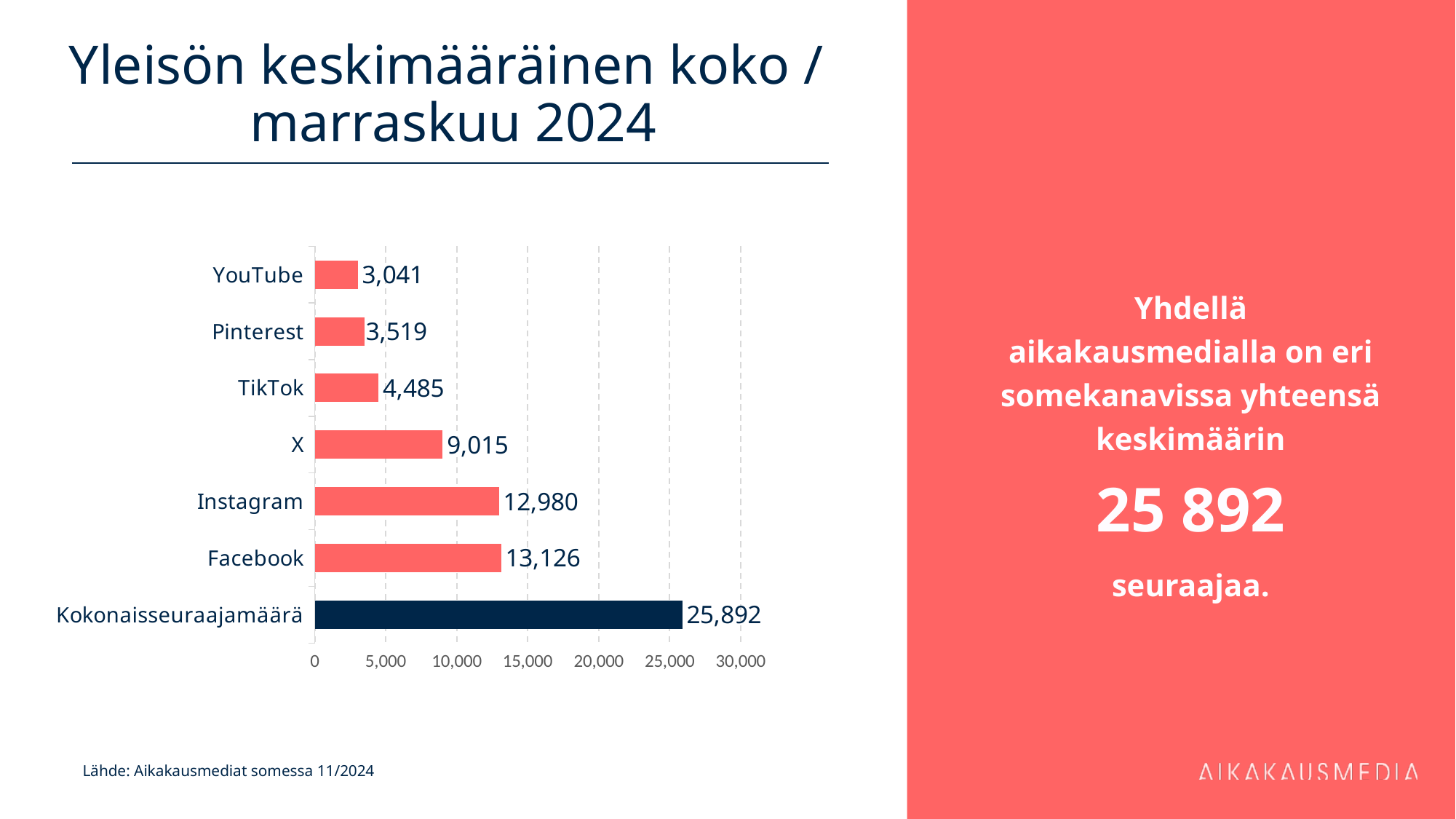
What is the value for Facebook? 13,126 Which category has the lowest value? YouTube How many categories are shown in the chart? 7 What is the value for Kokonaisseuraajamäärä? 25,892 Which is larger, the value for Pinterest or the value for YouTube? Pinterest What kind of chart is shown on the slide? bar chart What is the title of the slide? Yleisön keskimääräinen koko / marraskuu 2024 Which category has the highest value? Kokonaisseuraajamäärä What is the difference between the values for X and TikTok? 4,530 What is the difference between the values for Facebook and Instagram? 146 What is the value for TikTok? 4,485 Is the value for X greater or less than 10,000? less